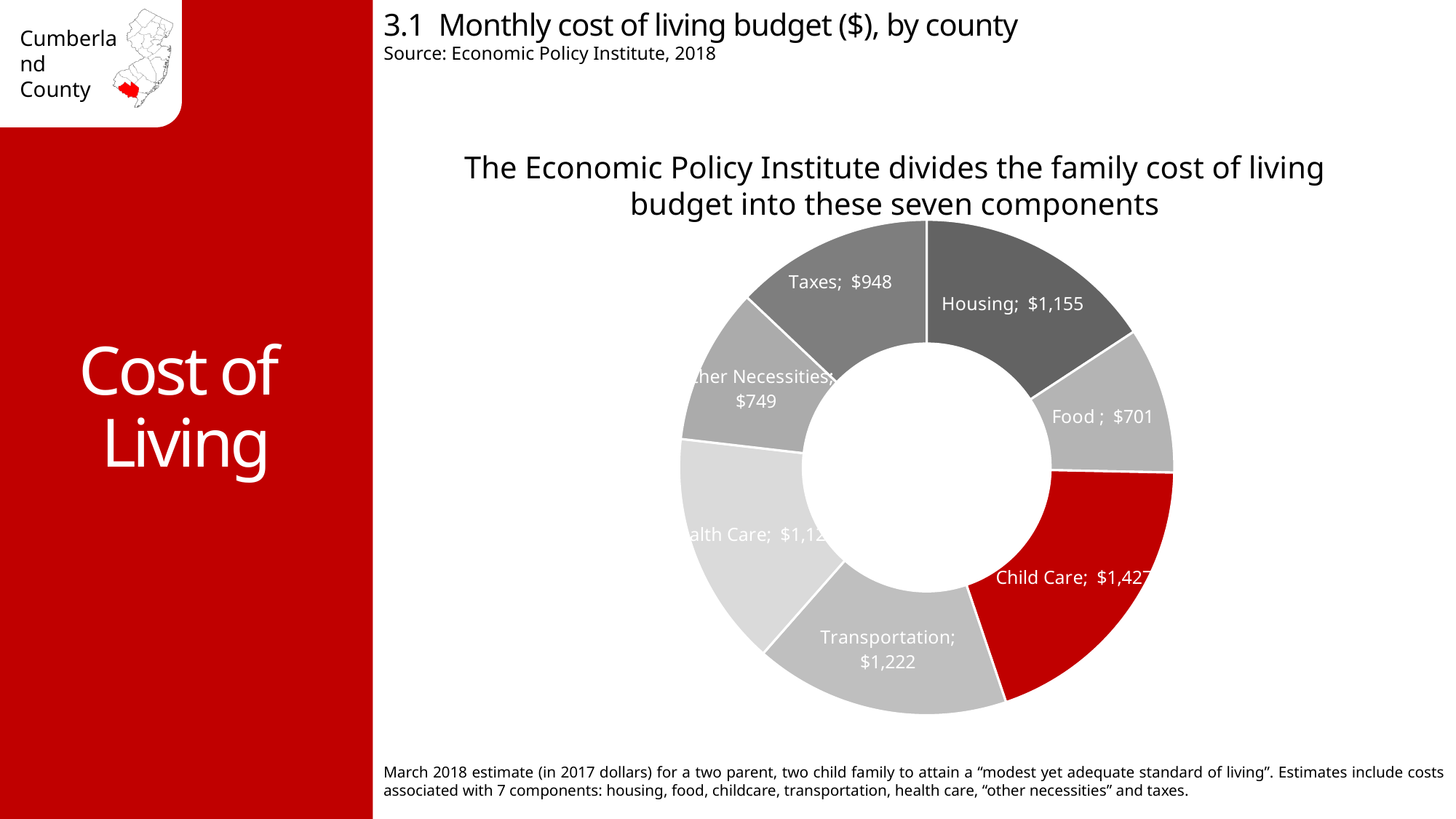
Which component has the highest monthly cost? Child Care What kind of chart is shown on the slide? doughnut chart What is the monthly cost for Housing? $1,155 What is the monthly cost for Food? $701 Which slice of the chart is coloured red? Child Care Which is larger, the monthly cost for Transportation or for Housing? Transportation What is the monthly cost for Child Care? $1,427 Which component has the lowest monthly cost? Food What is the monthly cost for Transportation? $1,222 What is the monthly cost for Taxes? $948 How many components (slices) does the chart show? 7 How much more is the monthly cost of Child Care than Housing? $272